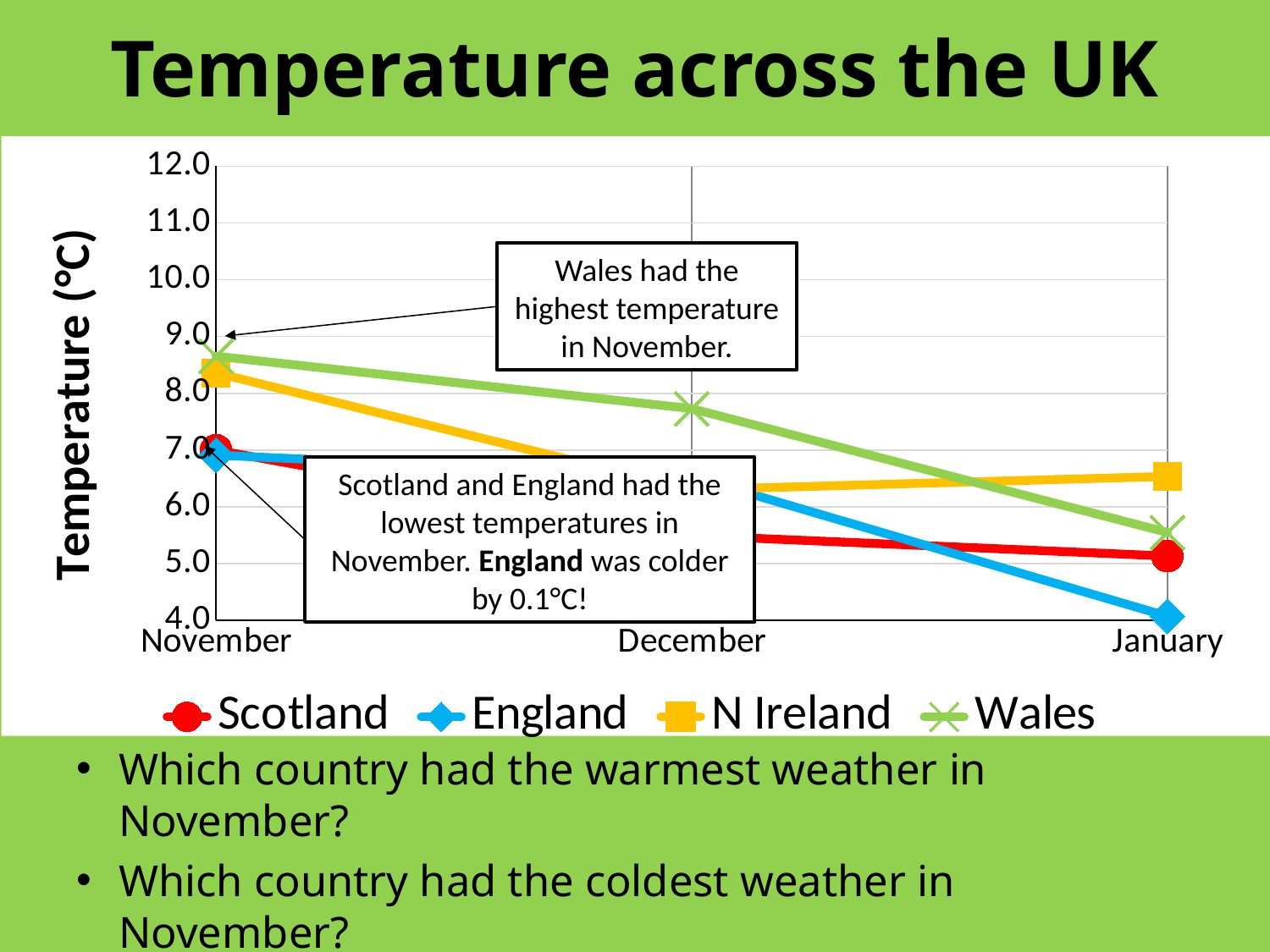
How many months are shown along the x axis? 3 Which country had the lowest temperature in January? England Which is higher in January, the temperature for N Ireland or for Scotland? N Ireland How many series does the legend list? 4 Is the temperature for England in January greater or less than 5.0? less Which country had the highest temperature in January? N Ireland Which country had the highest temperature in November? Wales Is the temperature for Wales in December greater or less than 7.0? greater What kind of chart is shown on the slide? line chart Does the temperature for Wales rise or fall from November to January? fall Is the temperature for Wales in November greater or less than 8.0? greater What is the title of the y axis? Temperature (°C)